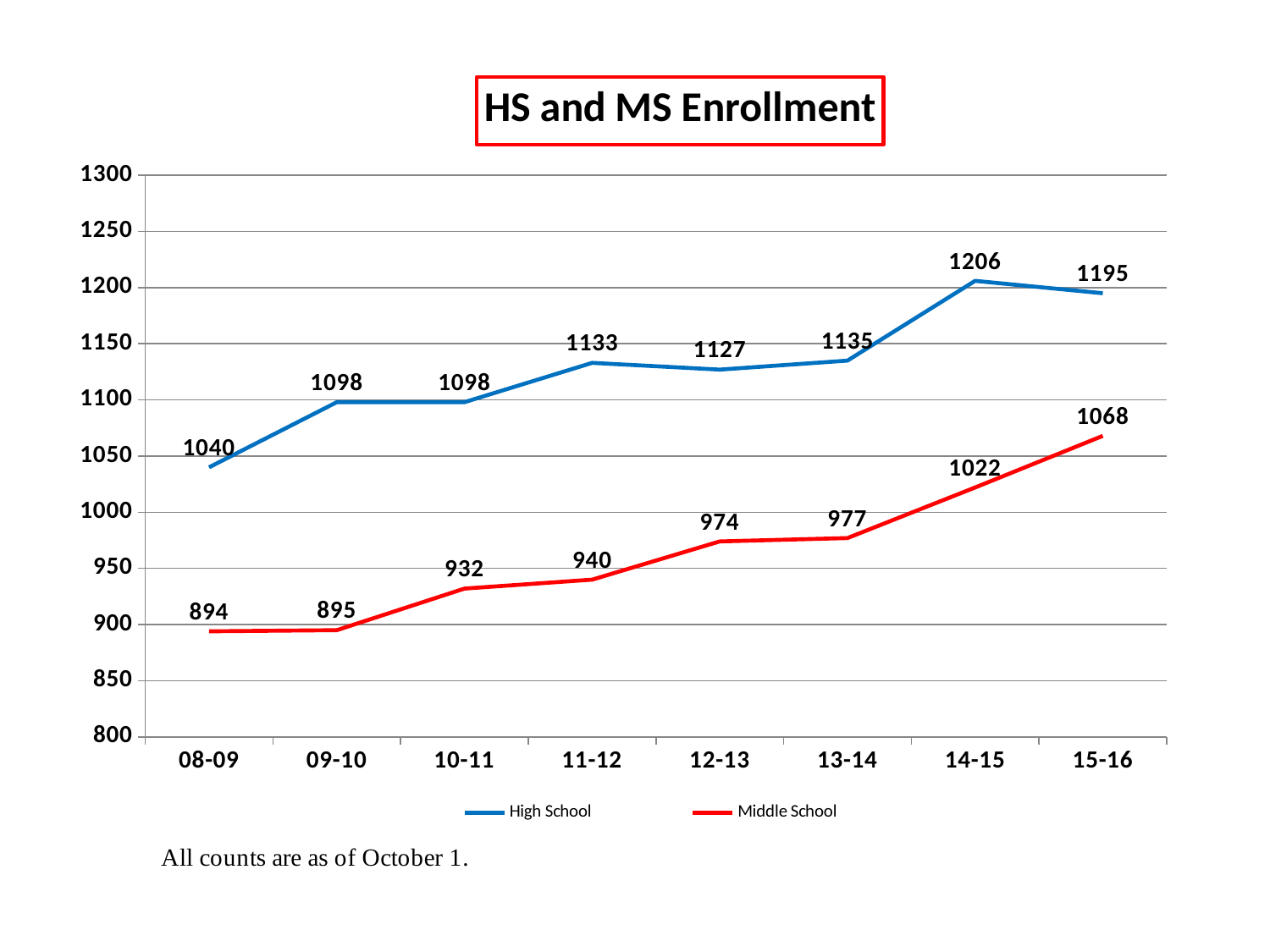
Is the Middle School enrollment for 13-14 greater or less than 1000? less How many series does the legend list? 2 What is the difference between High School and Middle School enrollment in 15-16? 127 Which is larger, High School enrollment in 12-13 or in 13-14? 13-14 In which year is High School enrollment lowest? 08-09 What is the Middle School enrollment for 10-11? 932 What is the High School enrollment for 14-15? 1206 What is the title of the chart? HS and MS Enrollment In which year is Middle School enrollment highest? 15-16 How many school years are shown on the x axis? 8 What kind of chart is shown? line chart By how much did Middle School enrollment change from 14-15 to 15-16? 46